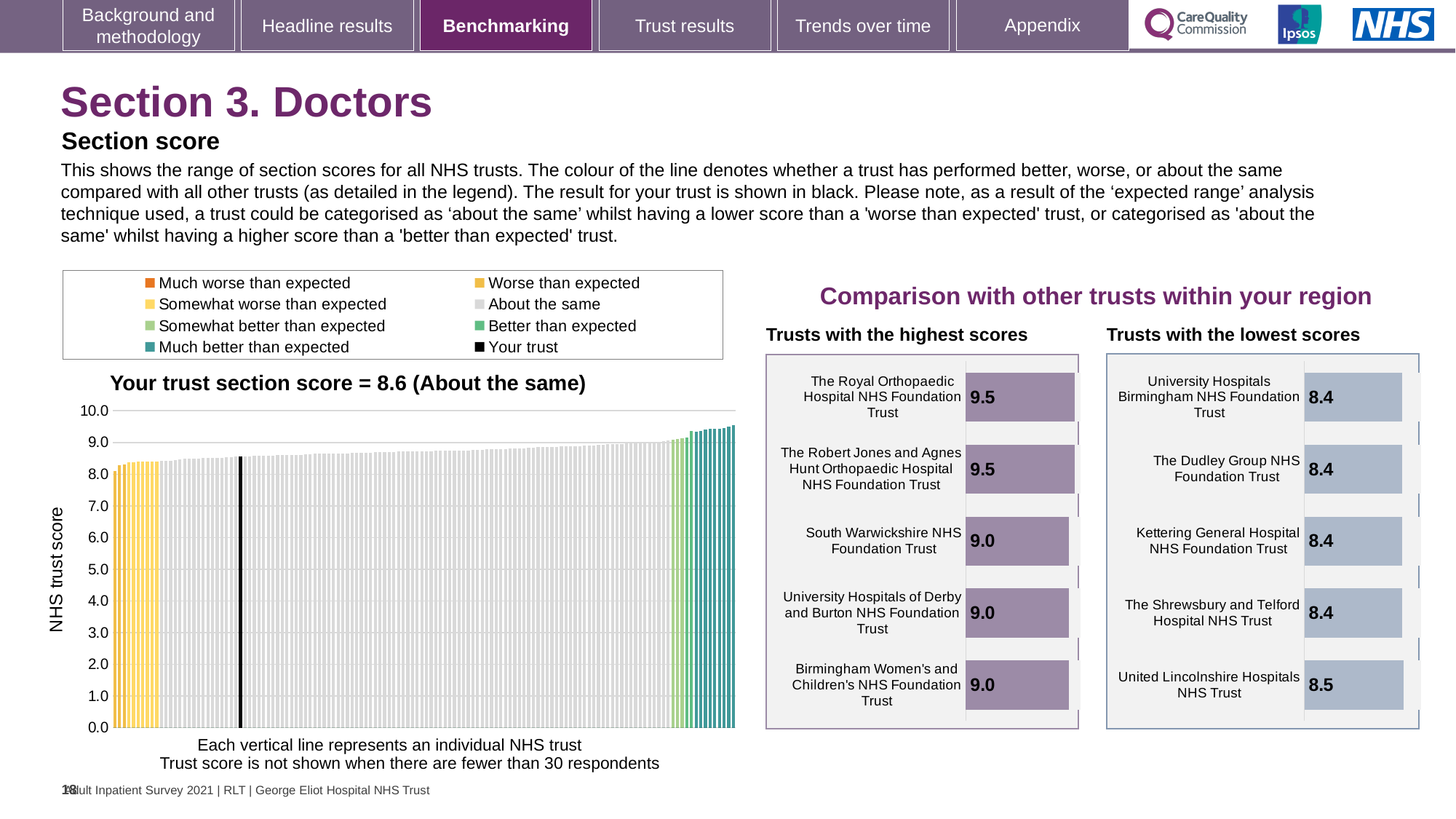
On the 'Your trust section score' chart, is the value for your trust greater or less than 8.0? greater On the 'Trusts with the highest scores' chart, what is the score for South Warwickshire NHS Foundation Trust? 9.0 What kind of chart is the 'Your trust section score' chart? bar chart How many entries does the legend above the 'Your trust section score' chart list? 8 On the 'Trusts with the lowest scores' chart, which has the higher score: United Lincolnshire Hospitals NHS Trust or The Dudley Group NHS Foundation Trust? United Lincolnshire Hospitals NHS Trust On the 'Your trust section score' chart, what is the section score for your trust? 8.6 On the 'Trusts with the lowest scores' chart, what is the score for United Lincolnshire Hospitals NHS Trust? 8.5 How many trusts are shown on the 'Trusts with the highest scores' chart? 5 On the 'Your trust section score' chart, which category is your trust placed in? About the same On the 'Your trust section score' chart, what is the label of the vertical axis? NHS trust score On the 'Trusts with the highest scores' chart, what is the difference between the scores of The Royal Orthopaedic Hospital NHS Foundation Trust and Birmingham Women's and Children's NHS Foundation Trust? 0.5 On the 'Trusts with the highest scores' chart, what is the score for The Royal Orthopaedic Hospital NHS Foundation Trust? 9.5